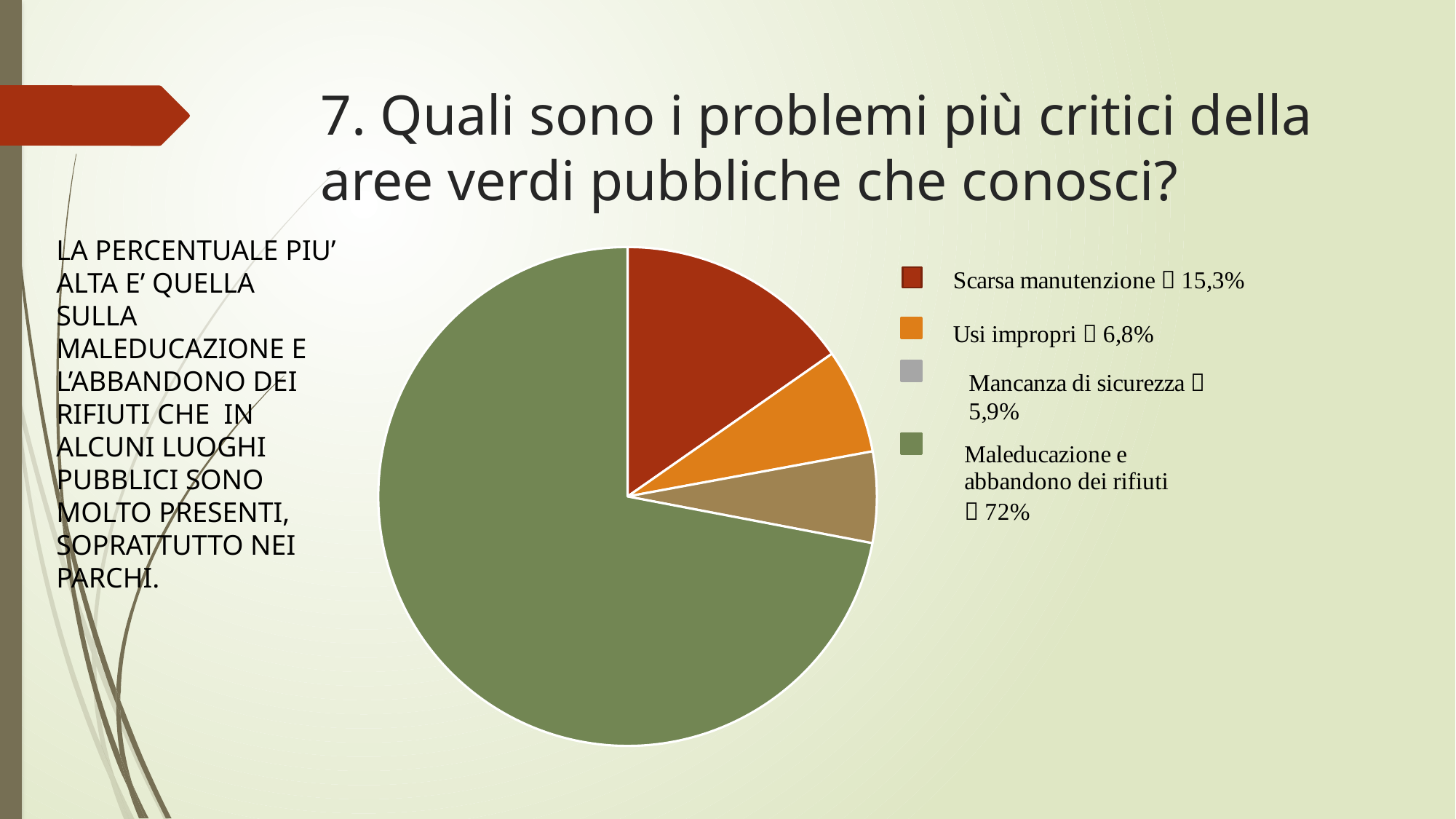
What percentage is shown for Scarsa manutenzione? 15,3% What percentage is shown for Mancanza di sicurezza? 5,9% How many slices does the pie chart have? 4 What percentage is shown for Maleducazione e abbandono dei rifiuti? 72% What is the difference in percentage points between Scarsa manutenzione and Usi impropri? 8,5 Which category has the largest share of the pie? Maleducazione e abbandono dei rifiuti What kind of chart is shown on the slide? pie chart Which category has the smallest share of the pie? Mancanza di sicurezza What is the difference in percentage points between Maleducazione e abbandono dei rifiuti and Scarsa manutenzione? 56,7 Which is larger, the share for Scarsa manutenzione or the share for Usi impropri? Scarsa manutenzione What colour is the slice for Scarsa manutenzione? dark red What percentage is shown for Usi impropri? 6,8%